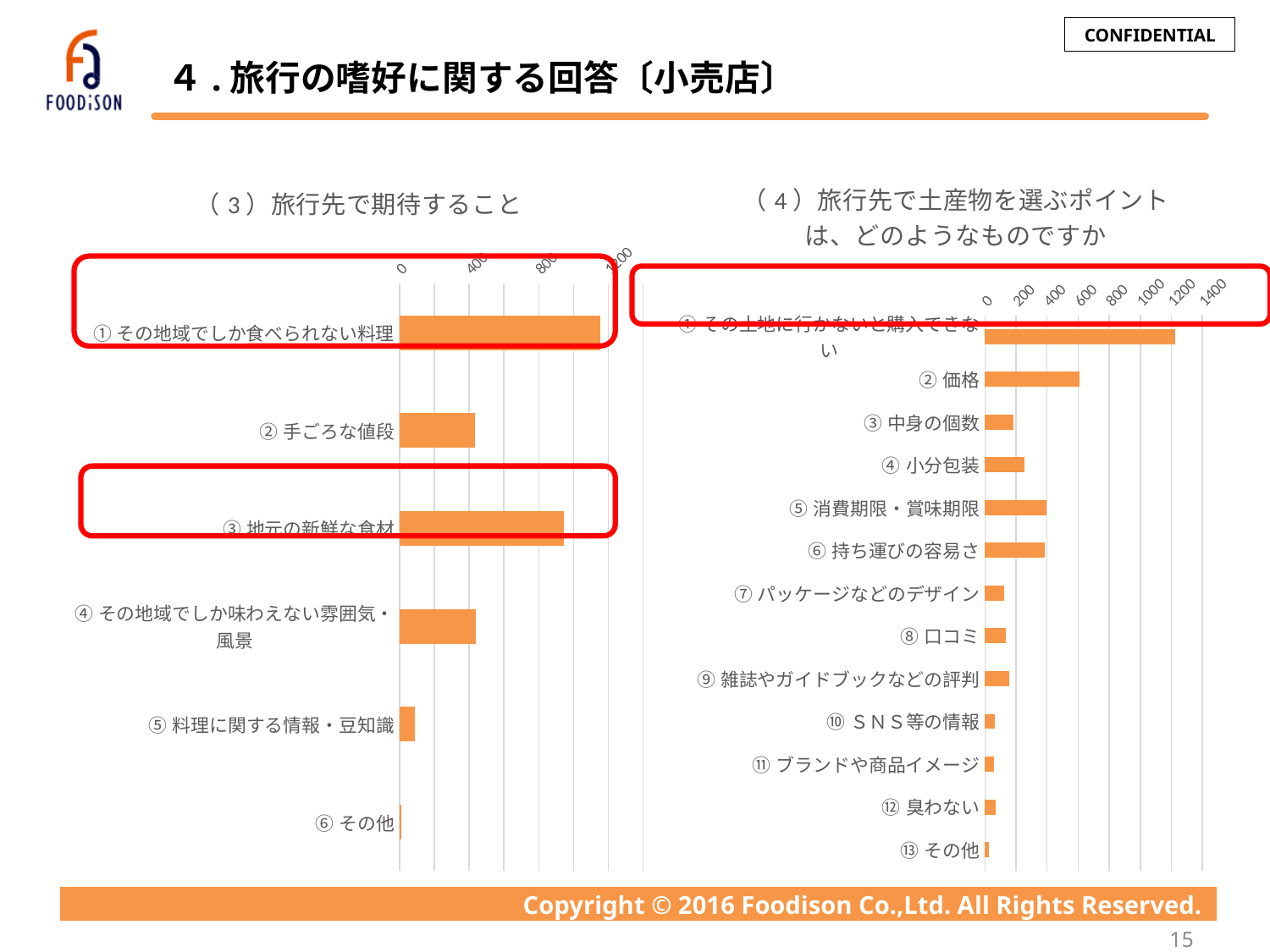
In the right chart （4）旅行先で土産物を選ぶポイント, which category has the highest value? ① その土地に行かないと購入できない In the right chart （4）旅行先で土産物を選ぶポイント, is the value for ② 価格 greater or less than 400? greater In the right chart （4）旅行先で土産物を選ぶポイント, which is larger: ② 価格 or ⑤ 消費期限・賞味期限? ② 価格 In the left chart （3）旅行先で期待すること, which is larger: ③ 地元の新鮮な食材 or ② 手ごろな値段? ③ 地元の新鮮な食材 In the left chart （3）旅行先で期待すること, is the value for ⑤ 料理に関する情報・豆知識 greater or less than 400? less In the left chart （3）旅行先で期待すること, which category has the highest value? ① その地域でしか食べられない料理 In the left chart （3）旅行先で期待すること, is the value for ③ 地元の新鮮な食材 greater or less than 800? greater In the left chart （3）旅行先で期待すること, which category has the lowest value? ⑥ その他 How many categories does the left chart （3）旅行先で期待すること show? 6 How many categories does the right chart （4）旅行先で土産物を選ぶポイント show? 13 What kind of chart is the left chart titled （3）旅行先で期待すること? bar chart